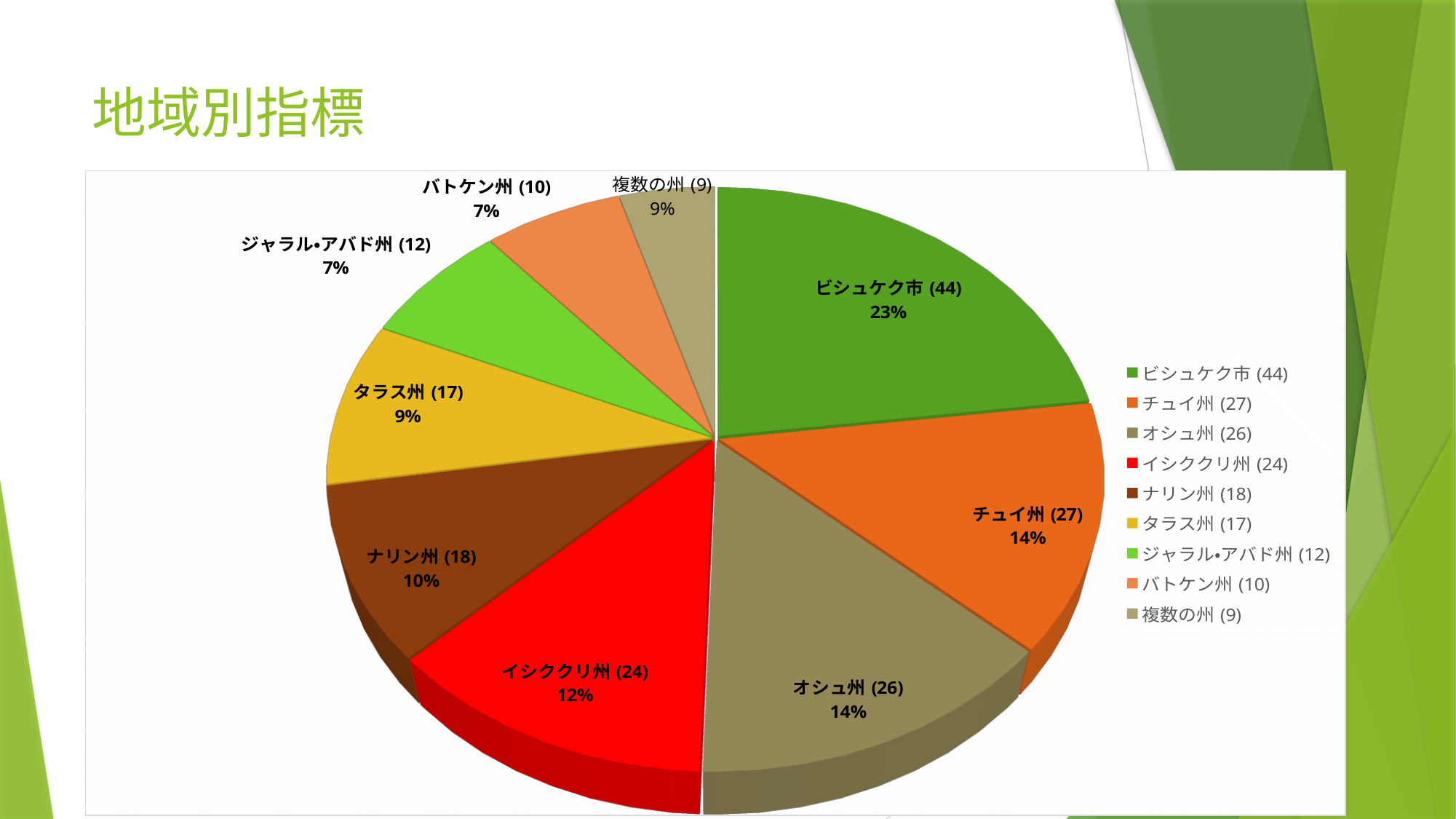
What is the value shown for ナリン州? 18 What is the difference between the values for チュイ州 and バトケン州? 17 Which category has the smallest slice of the pie? 複数の州 (9) What percentage share of the pie does ビシュケク市 have? 23% What kind of chart is shown on the slide? pie chart What is the title of the slide containing the pie chart? 地域別指標 What is the value shown for ビシュケク市? 44 Which is larger, the value for タラス州 or the value for ジャラル・アバド州? タラス州 Which category has the largest slice of the pie? ビシュケク市 (44) What percentage share of the pie does イシククリ州 have? 12% How many slices does the pie chart have? 9 How many entries does the legend list? 9